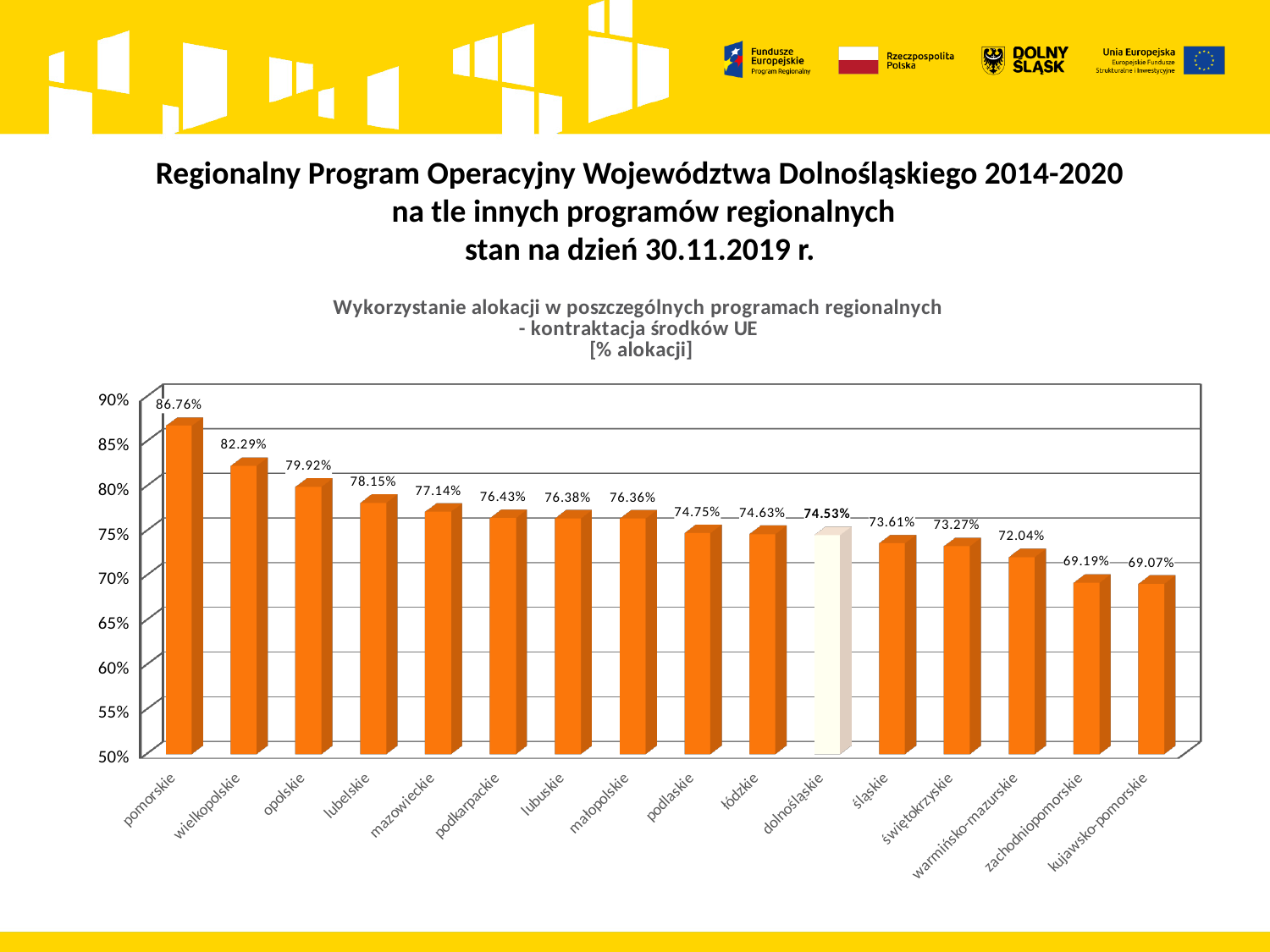
What kind of chart is shown on the slide? bar chart What is the value for warmińsko-mazurskie? 72.04% Which region has the highest value? pomorskie Which bar is shown in a different colour from the others? dolnośląskie Is the value for zachodniopomorskie greater or less than 70%? less How many regions are shown on the chart? 16 What is the difference between the values for dolnośląskie and śląskie? 0.92 percentage points What is the value for pomorskie? 86.76% What is the difference between the values for pomorskie and kujawsko-pomorskie? 17.69 percentage points Which is larger, the value for wielkopolskie or the value for opolskie? wielkopolskie Which region has the lowest value? kujawsko-pomorskie What is the value for dolnośląskie? 74.53%